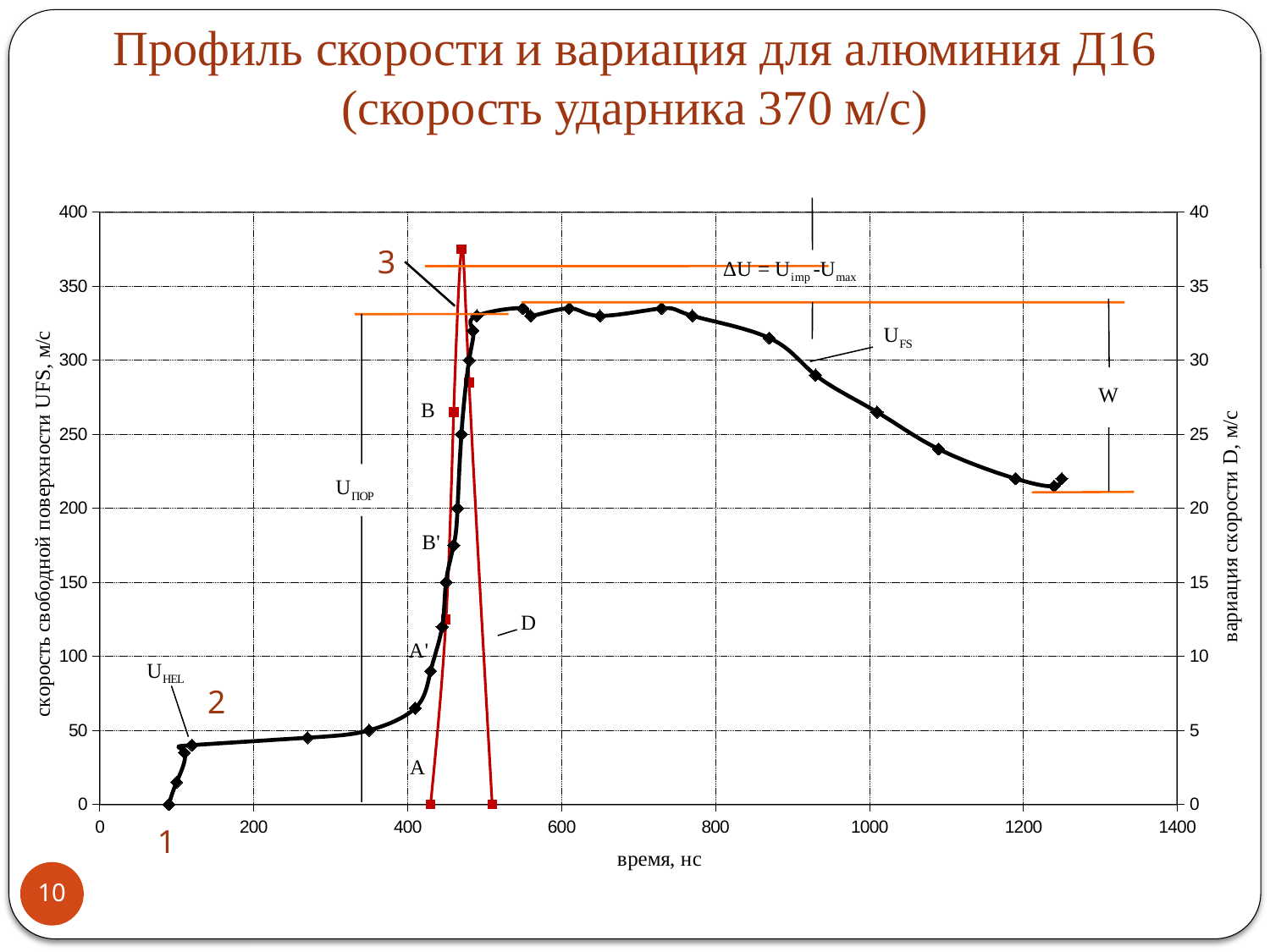
Is the value of the black curve at 350 нс greater or less than 100 on the left axis? less What kind of chart is shown on the slide? line chart Which is larger for the black curve: the value at 600 нс or the value at 1200 нс? 600 нс Is the value of the black curve at 200 нс greater or less than 50 on the left axis? less What is the maximum value shown on the left y axis? 400 Is the value of the black curve at 1200 нс greater or less than 250 on the left axis? less Does the black curve rise or fall between 400 нс and 500 нс? rise What is the title of the right-hand y axis of the chart? вариация скорости D, м/с What is the title of the x axis of the chart? время, нс Does the black curve rise or fall between 800 нс and 1200 нс? fall